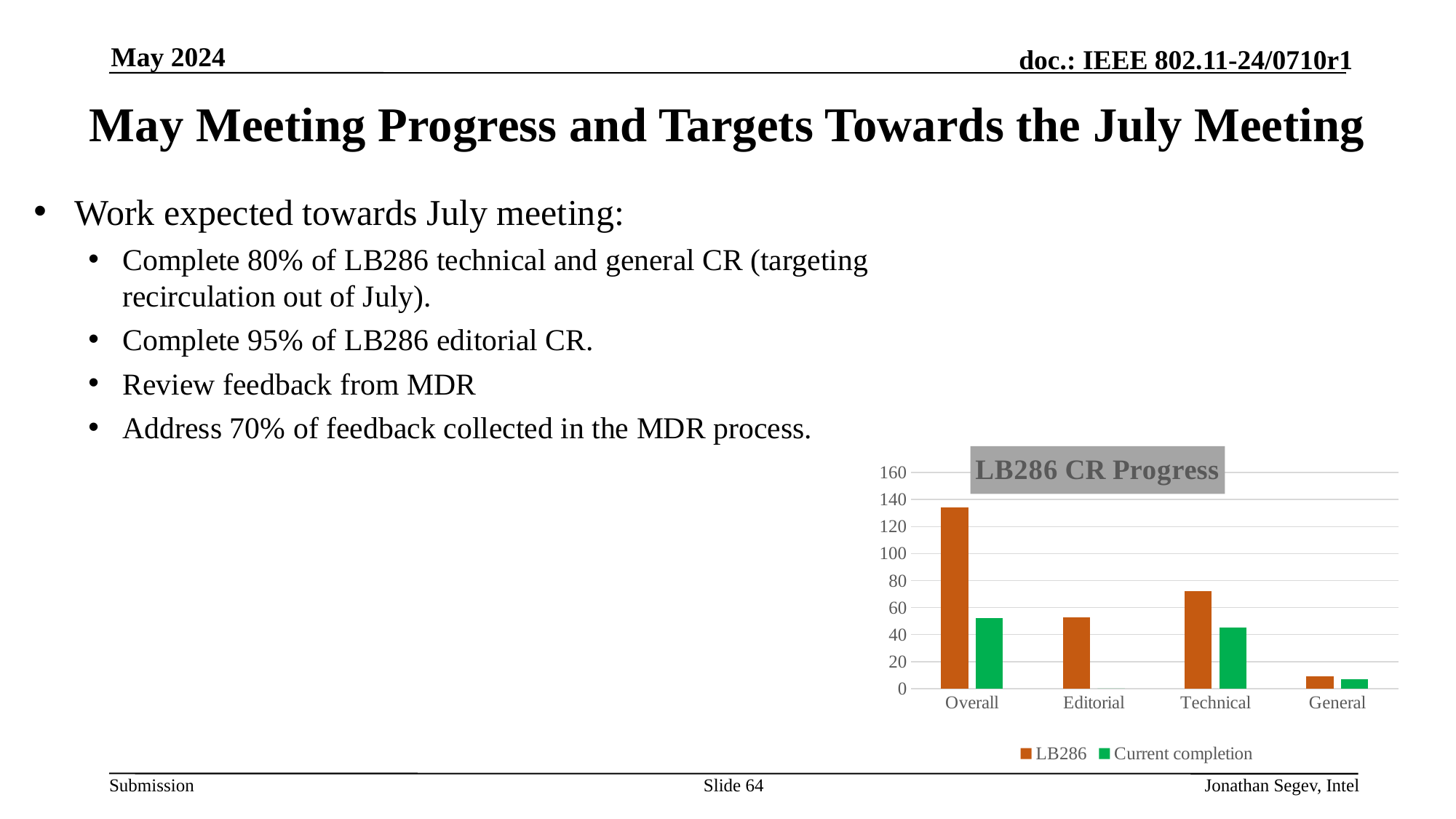
Which colour represents the Current completion series in the chart? green Is the LB286 value for Technical greater or less than 60? greater Is the LB286 value for General greater or less than 20? less How many categories are shown on the x axis of the chart? 4 Is the Current completion value for Overall greater or less than 40? greater What is the title of the chart? LB286 CR Progress Which category has the highest LB286 value? Overall Which category has the lowest LB286 value? General How many series does the chart legend list? 2 What kind of chart is shown on the slide? bar chart Which is larger, the LB286 value for Overall or the LB286 value for Technical? Overall